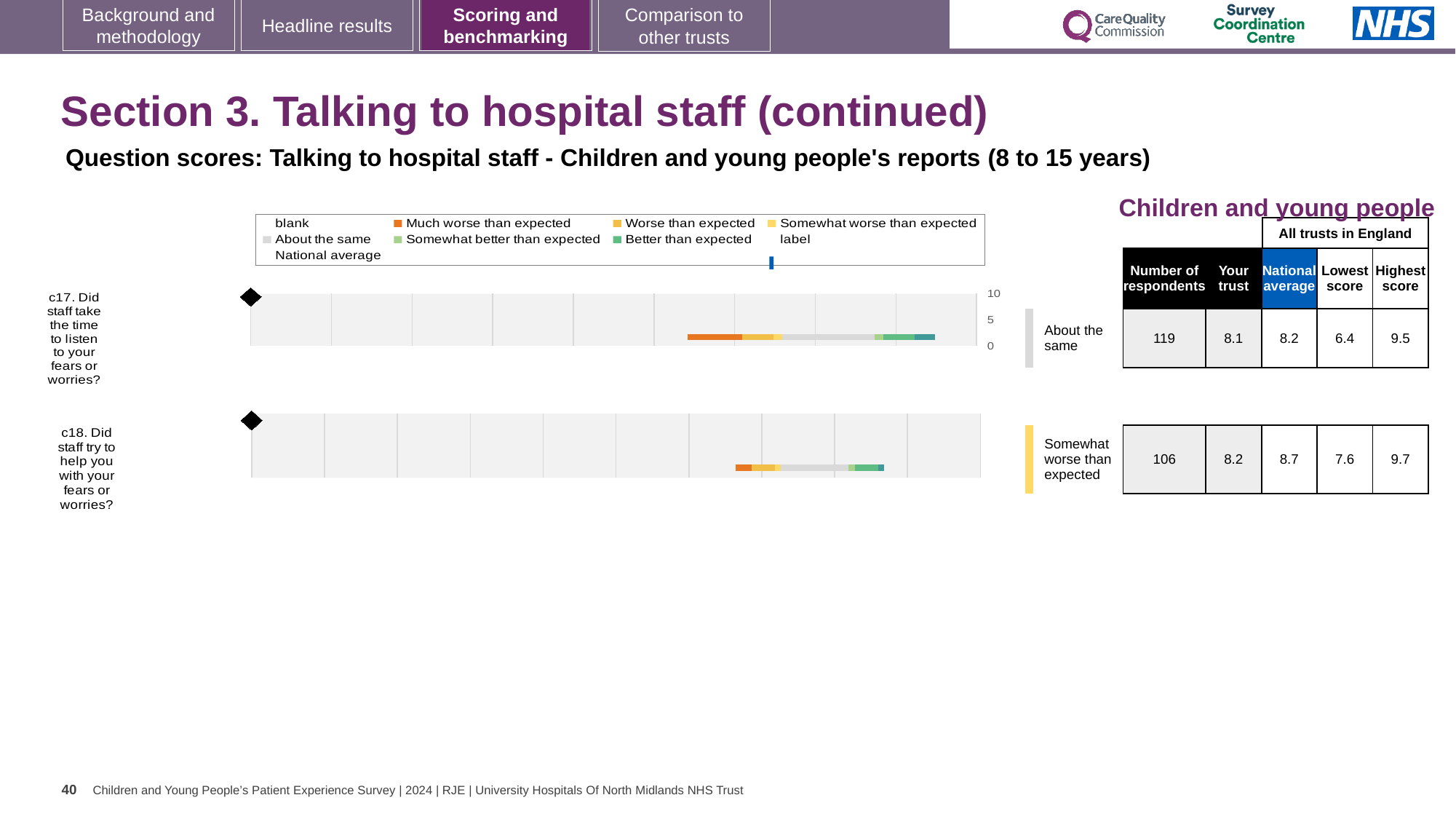
What is the lowest score among all trusts in England for c18? 7.6 What is the national average score for c17? 8.2 Which benchmarking category is the trust's score for c18 placed in? Somewhat worse than expected What is the national average score for c18? 8.7 What is the difference between the national average and the trust's score for c18? 0.5 What is the 'Your trust' score for c18 (Did staff try to help you with your fears or worries?)? 8.2 What is the difference between the highest and lowest scores for c17? 3.1 What is the highest score among all trusts in England for c18? 9.7 How many respondents answered question c17? 119 How many questions (categories) are plotted on the slide? 2 What kind of chart is used to show the question scores for c17 and c18? bar chart What is the 'Your trust' score for c17 (Did staff take the time to listen to your fears or worries?)? 8.1